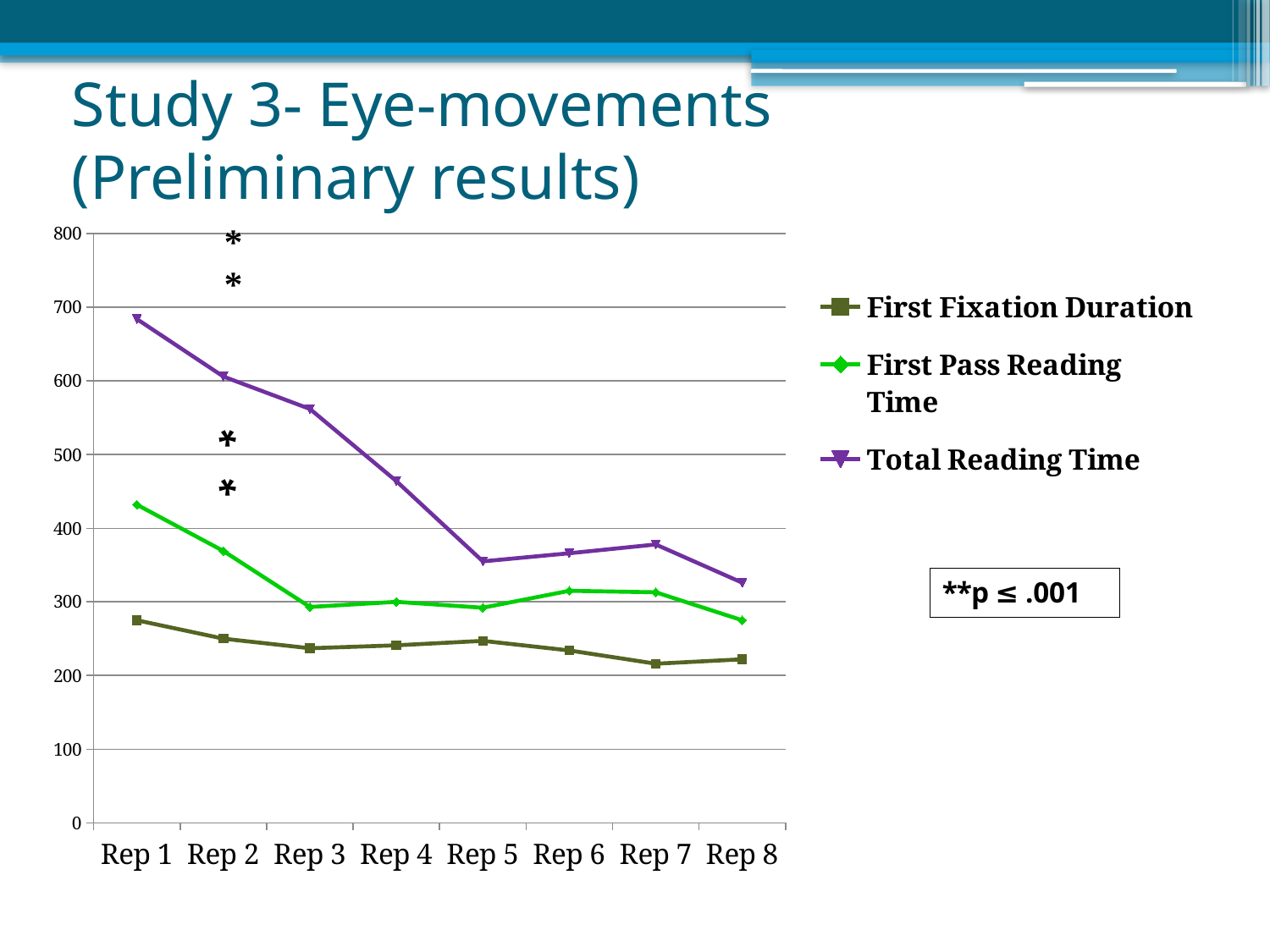
What significance note is shown in the box next to the legend? **p ≤ .001 How many series does the legend list? 3 Which series has the highest values across all repetitions? Total Reading Time Is the First Fixation Duration value for Rep 1 greater or less than 300? less Does Total Reading Time generally rise or fall from Rep 1 to Rep 5? Fall Is the Total Reading Time value for Rep 1 greater or less than 600? greater At which repetition is Total Reading Time lowest? Rep 8 Is the First Pass Reading Time value for Rep 1 greater or less than 400? greater How many repetitions (categories) are shown on the x axis? 8 At which repetition is Total Reading Time highest? Rep 1 What kind of chart is shown on the slide? Line chart